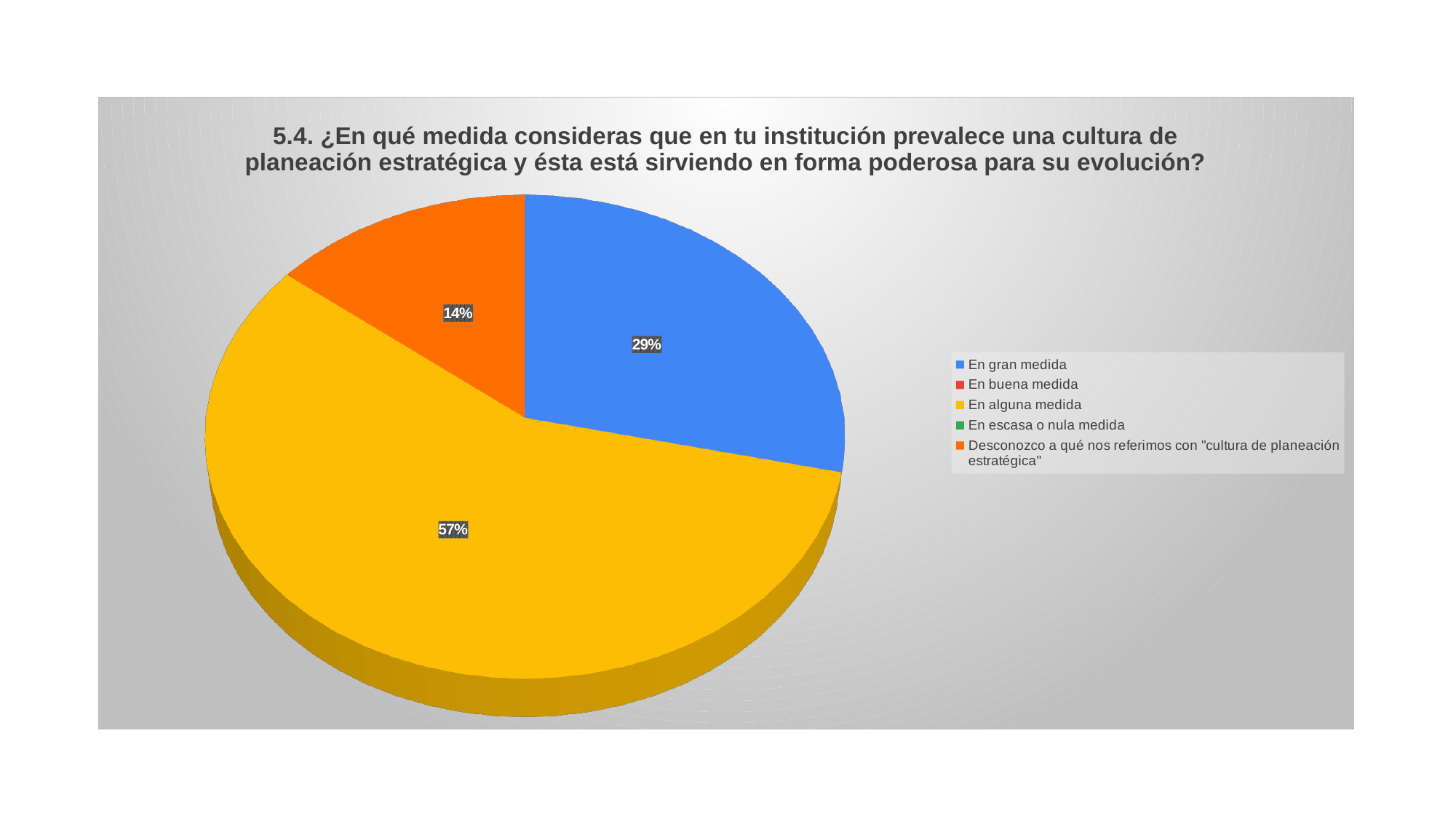
What is the difference in percentage points between 'En alguna medida' and 'En gran medida'? 28 Which of the visible slices is the smallest? Desconozco a qué nos referimos con "cultura de planeación estratégica" How many entries does the legend list? 5 What is the combined share of 'En gran medida' and 'En alguna medida'? 86% What kind of chart is shown on the slide? Pie chart What share of responses is 'Desconozco a qué nos referimos con "cultura de planeación estratégica"'? 14% Which category has the largest slice of the pie? En alguna medida How many slices with data labels are visible in the pie? 3 What colour is the slice for 'En alguna medida'? Yellow What share of responses is 'En gran medida'? 29% Which is larger, the share for 'En gran medida' or the share for 'Desconozco a qué nos referimos con "cultura de planeación estratégica"'? En gran medida What share of responses is 'En alguna medida'? 57%